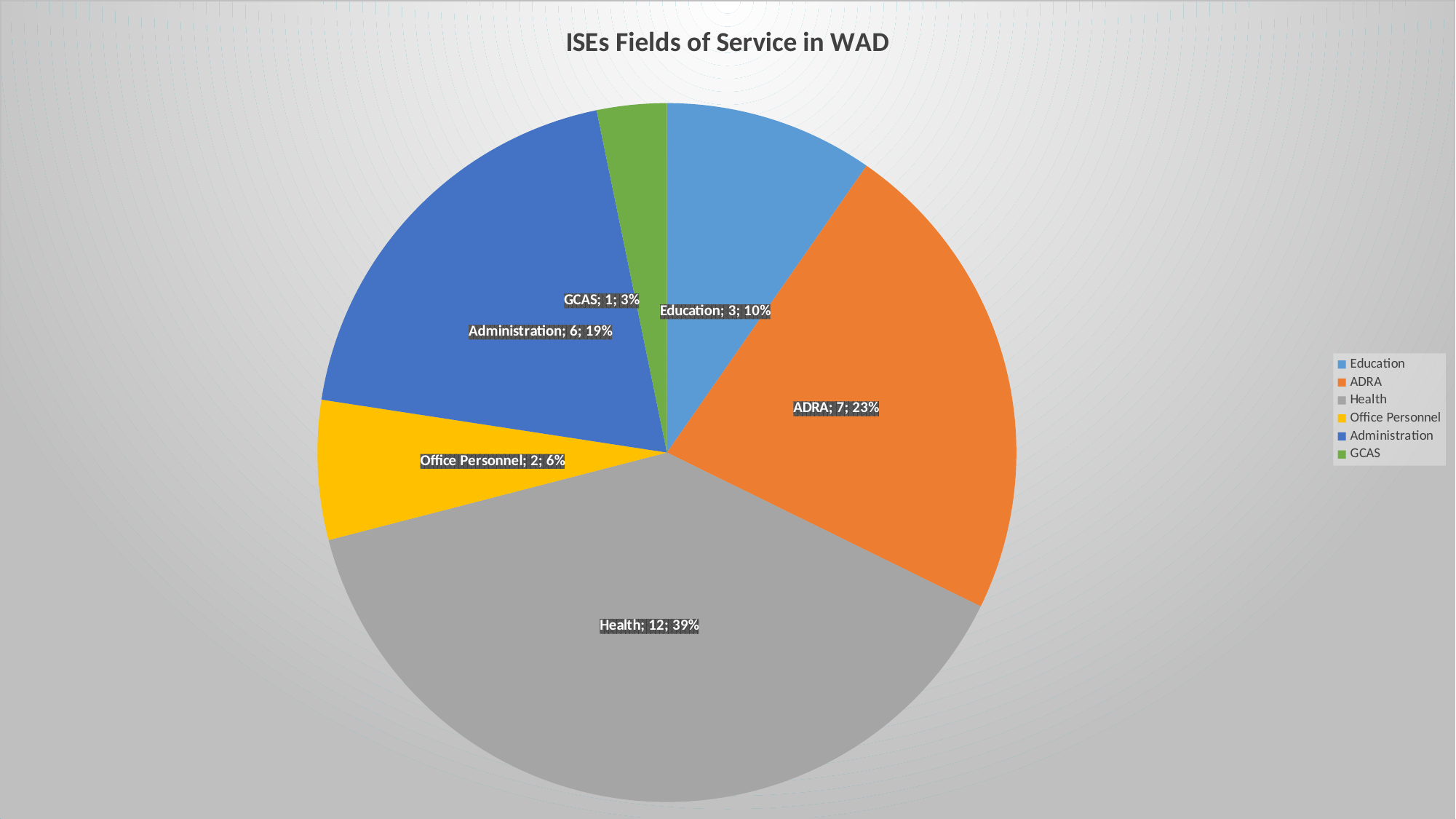
What is the title of the chart? ISEs Fields of Service in WAD What kind of chart is shown on the slide? pie chart What is the value for Health? 12 What share of the pie does Office Personnel represent? 6% Which category has the smallest slice? GCAS What is the difference between the values for Health and ADRA? 5 Which category has the largest slice? Health What is the value for ADRA? 7 What is the value for Administration? 6 What share of the pie does Education represent? 10% How many categories does the pie chart have? 6 Which is larger, the value for Administration or the value for Office Personnel? Administration